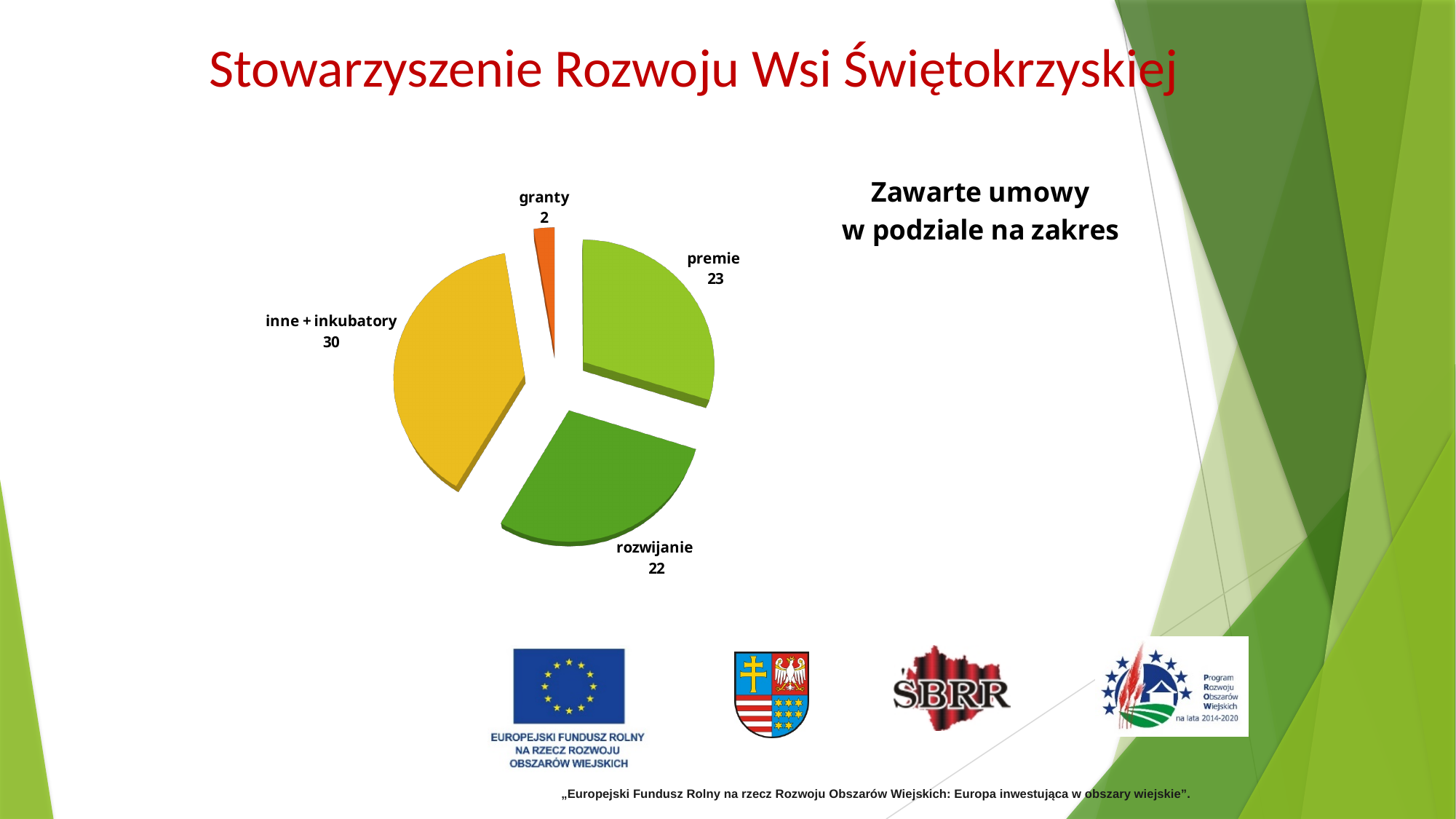
Which category has the smallest slice in the pie chart? granty What is the value of the 'inne + inkubatory' slice in the pie chart? 30 What is the total of all the slice values in the pie chart? 77 Which is larger, the 'premie' value or the 'rozwijanie' value? premie How many slices does the pie chart have? 4 What type of chart is shown on the slide? pie chart What is the value of the 'rozwijanie' slice in the pie chart? 22 What is the value of the 'premie' slice in the pie chart? 23 What is the value of the 'granty' slice in the pie chart? 2 What is the difference between the 'inne + inkubatory' value and the 'premie' value? 7 What is the title shown next to the pie chart? Zawarte umowy w podziale na zakres Which category has the largest slice in the pie chart? inne + inkubatory